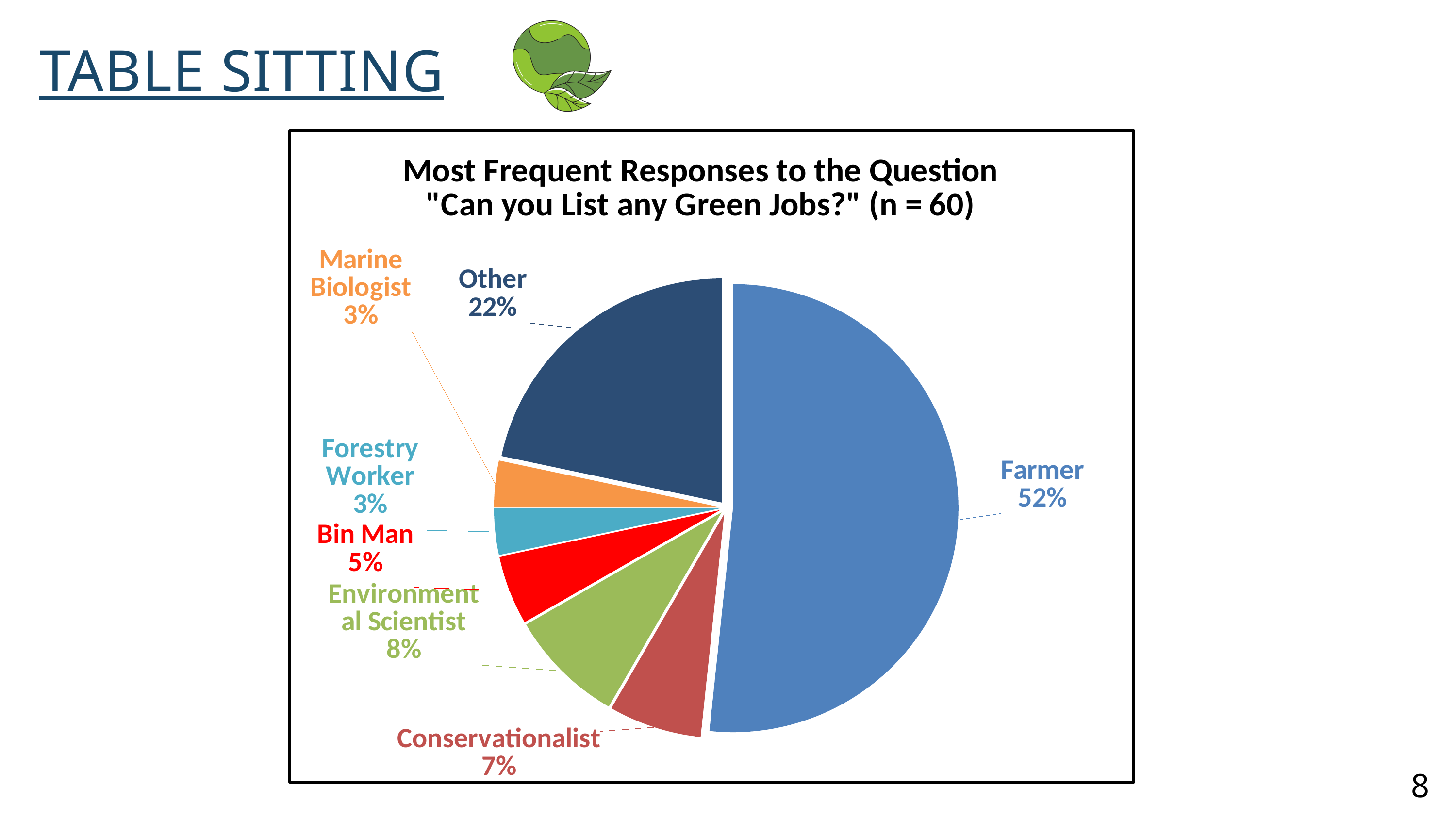
What share of responses is Bin Man? 5% How many slices does the pie chart have? 7 What is the difference in percentage points between Farmer and Other? 30 What is the sample size (n) stated in the chart title? 60 Which is larger, the share for Environmental Scientist or the share for Bin Man? Environmental Scientist What share of responses is Conservationalist? 7% What colour is the Farmer slice? blue Which response has the largest share of the pie? Farmer What share of responses is Other? 22% What kind of chart is shown on the slide? pie chart What share of responses is Environmental Scientist? 8% What share of responses is Farmer? 52%